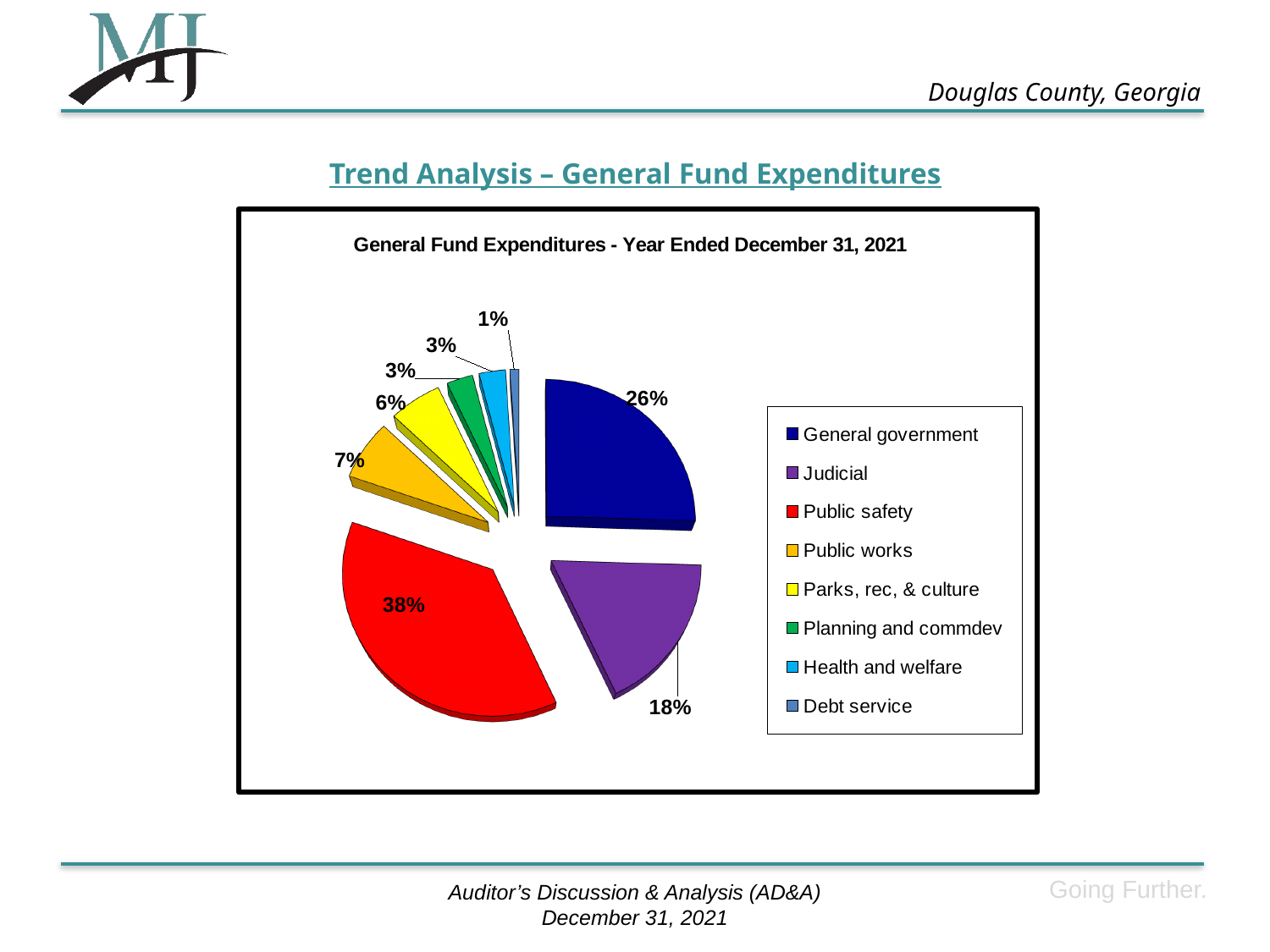
What share of General Fund Expenditures is Public works? 7% How many categories does the legend of the pie chart list? 8 What share of General Fund Expenditures is Public safety? 38% What is the difference in percentage points between the Public safety share and the General government share? 12 percentage points Which category has the smallest share of General Fund Expenditures? Debt service What share of General Fund Expenditures is Debt service? 1% Which is larger, the Judicial share or the Public works share? Judicial Which category has the largest share of General Fund Expenditures? Public safety What is the title of the pie chart? General Fund Expenditures - Year Ended December 31, 2021 What kind of chart is shown on the slide? Pie chart